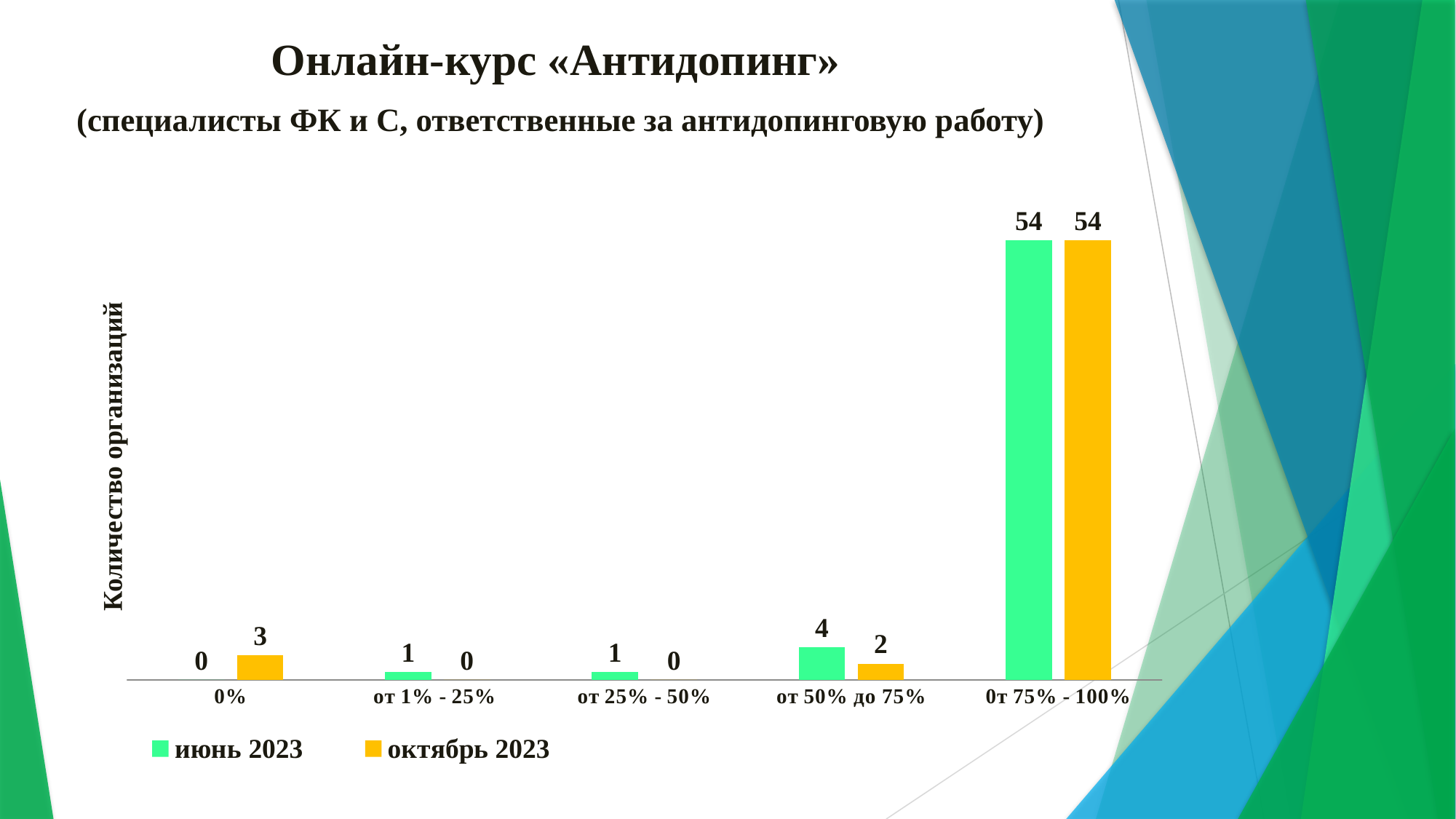
What is the value for "июнь 2023" in the "0%" category? 0 What is the value for "октябрь 2023" in the "от 75% - 100%" category? 54 What is the total of the "июнь 2023" and "октябрь 2023" values in the "от 75% - 100%" category? 108 What is the value for "июнь 2023" in the "от 50% до 75%" category? 4 What is the label of the vertical axis? Количество организаций In the "0%" category, which series has the larger value, "июнь 2023" or "октябрь 2023"? октябрь 2023 What kind of chart is shown on the slide? bar chart Which category has the highest value for "октябрь 2023"? от 75% - 100% How many series does the legend list? 2 What is the value for "октябрь 2023" in the "0%" category? 3 How many categories are shown on the x axis? 5 What is the difference between the "июнь 2023" and "октябрь 2023" values in the "от 50% до 75%" category? 2